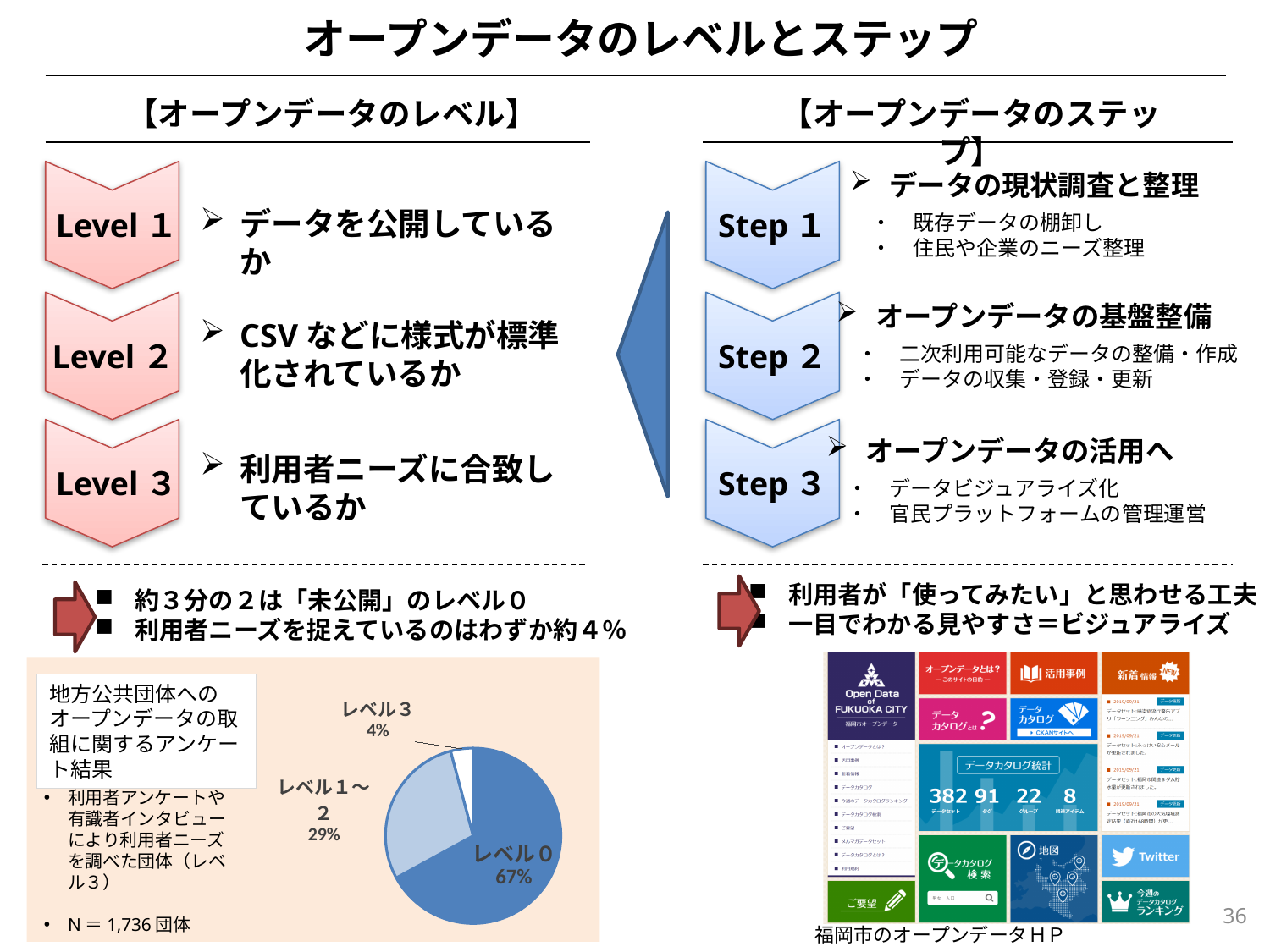
What kind of chart is shown on the slide? pie chart How many slices does the pie chart have? 3 What is the difference in percentage points between レベル０ and レベル１～２ in the pie chart? 38 What is the combined share of レベル１～２ and レベル３ in the pie chart? 33% Which slice of the pie chart is the smallest? レベル３ What share of the pie chart is レベル１～２? 29% Which slice of the pie chart is the largest? レベル０ What share of the pie chart is レベル３? 4% What share of the pie chart is レベル０? 67% Which is larger in the pie chart, レベル１～２ or レベル３? レベル１～２ What is the sample size (N) stated next to the pie chart? 1,736 団体 What is the difference in percentage points between レベル１～２ and レベル３ in the pie chart? 25